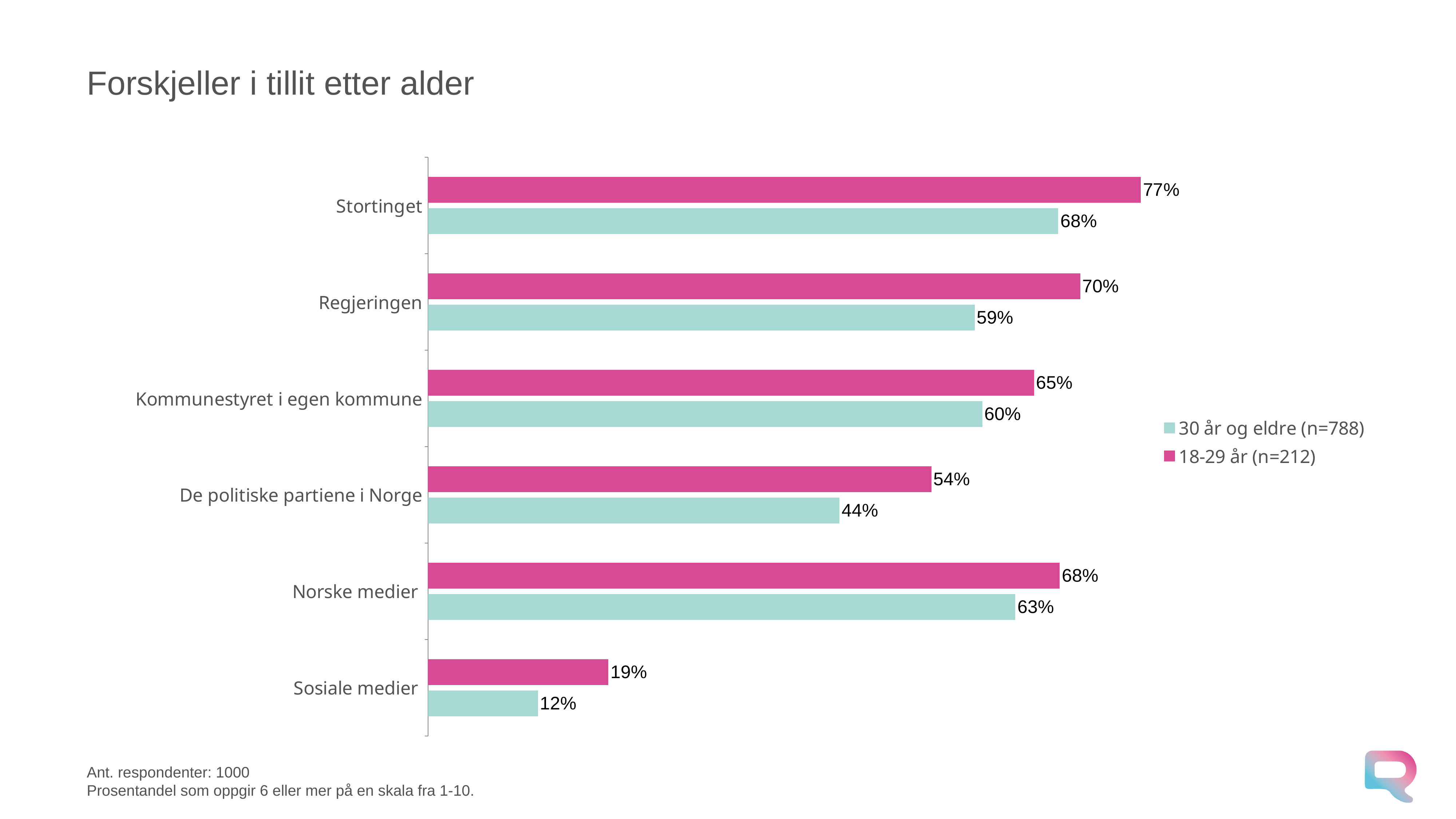
Which category has the highest value in the 18-29 år (n=212) series? Stortinget How many categories are shown on the chart? 6 What is the value for Regjeringen in the 30 år og eldre (n=788) series? 59% What is the difference between the 18-29 år and 30 år og eldre values for Regjeringen? 11% Which is larger for Norske medier: the 18-29 år value or the 30 år og eldre value? 18-29 år What is the value for Stortinget in the 18-29 år (n=212) series? 77% What is the difference between the 18-29 år and 30 år og eldre values for De politiske partiene i Norge? 10% Which category has the lowest value in the 30 år og eldre (n=788) series? Sosiale medier How many series does the legend list? 2 What is the value for Sosiale medier in the 18-29 år (n=212) series? 19% What kind of chart is shown on the slide? Bar chart What is the title of the slide? Forskjeller i tillit etter alder